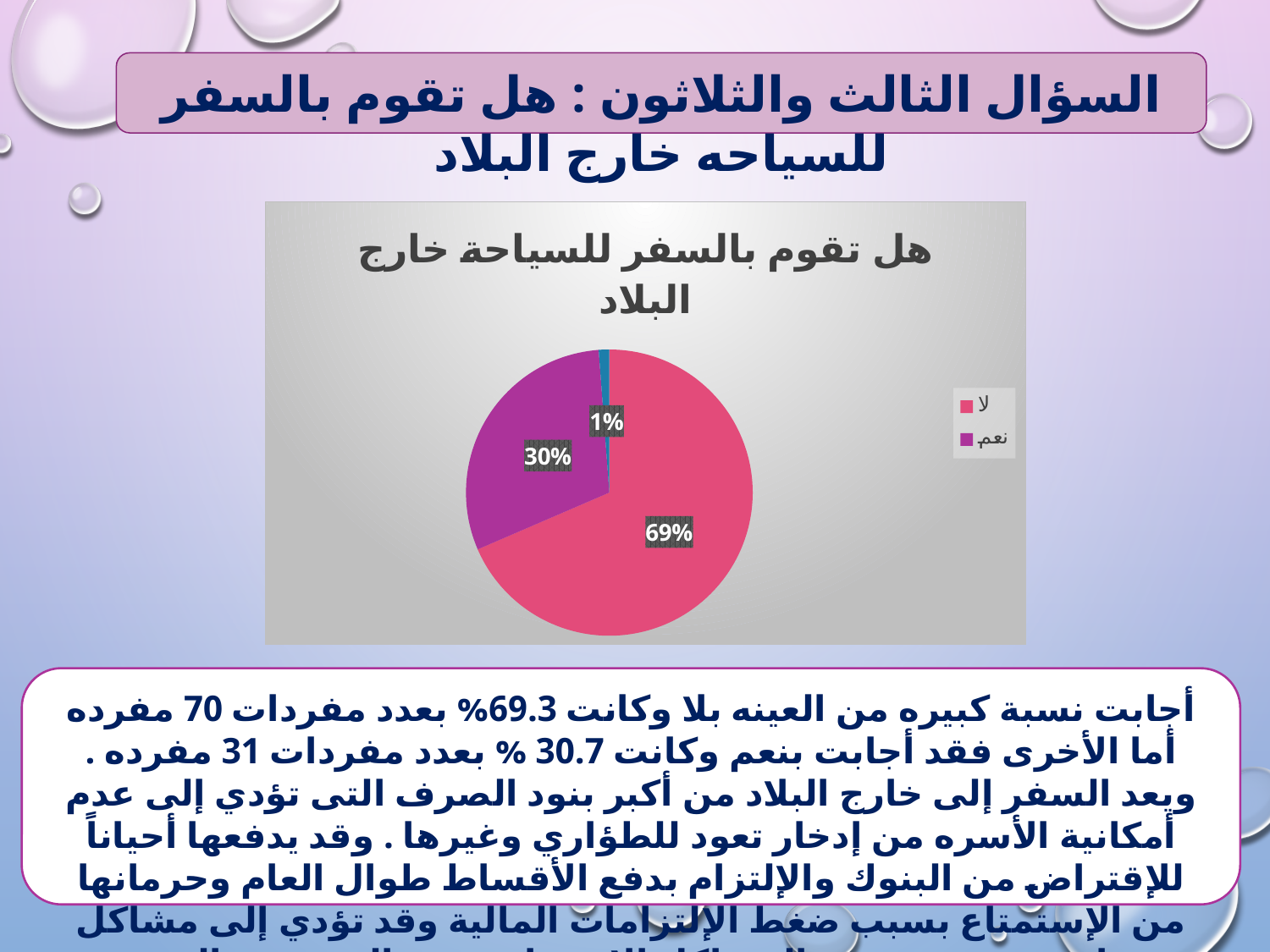
Which legend category has the smaller share of the pie, "لا" or "نعم"? نعم Which slice is larger, "لا" or "نعم"? لا How many slices does the pie chart have? 3 What is the title of the chart? هل تقوم بالسفر للسياحة خارج البلاد What type of chart is shown on the slide? pie chart What percentage of the pie is labelled for the "نعم" slice? 30% What colour is the "نعم" slice in the pie chart? purple Which legend category has the largest share of the pie? لا What is the difference in percentage points between the "لا" slice and the "نعم" slice? 39 What percentage of the pie is labelled for the "لا" slice? 69% How many entries does the legend list? 2 What is the value shown on the smallest slice of the pie? 1%